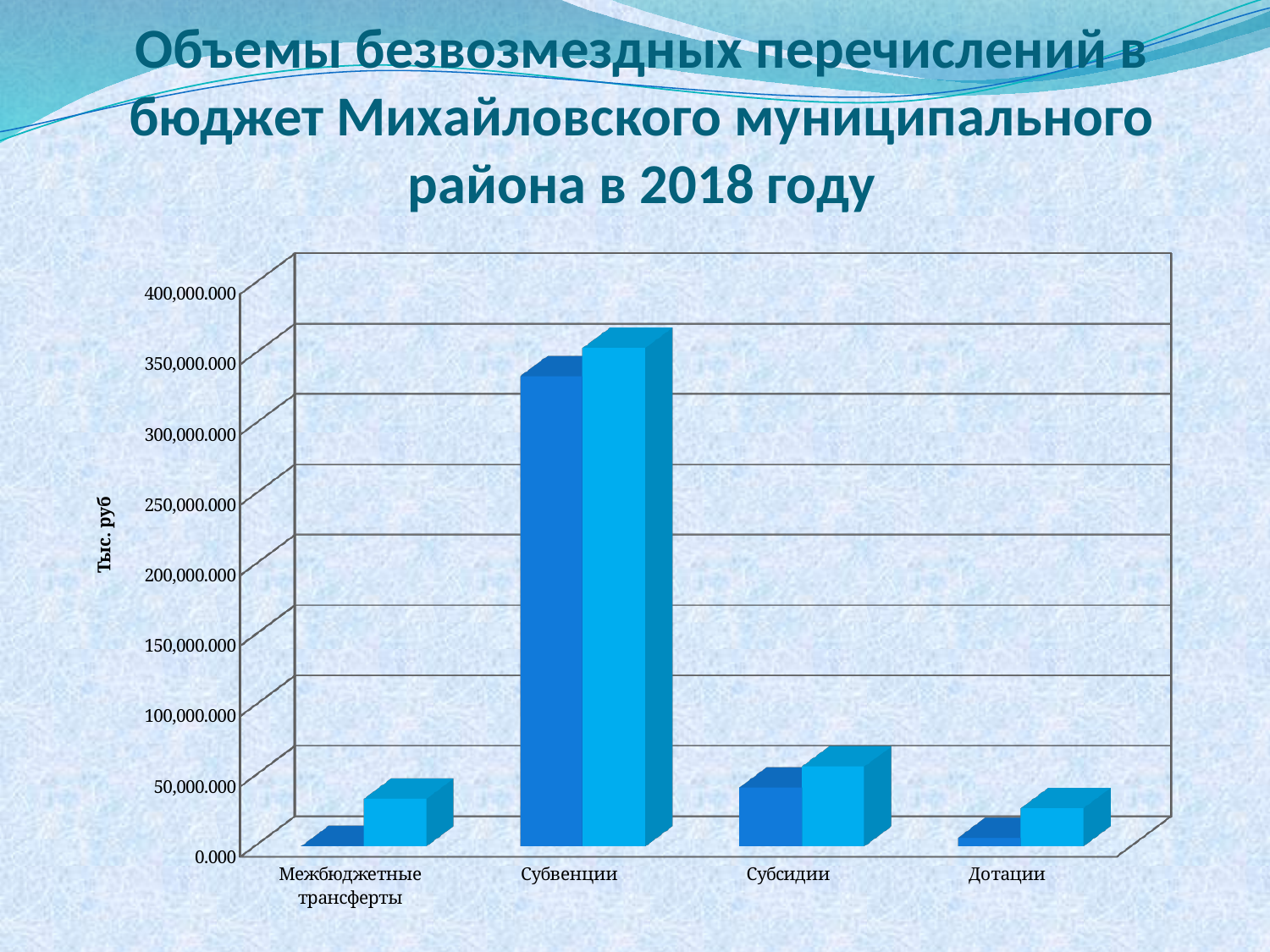
Which category has larger bars, Субвенции or Субсидии? Субвенции Which category has the highest bars in the chart? Субвенции Is the light blue bar for Субвенции greater or less than 300,000.000? greater How many categories are shown on the x axis of the chart? 4 Is the dark blue bar for Дотации greater or less than 50,000.000? less Is the light blue bar for Субвенции greater or less than 400,000.000? less Which category has the lowest dark blue bar in the chart? Межбюджетные трансферты What is the label on the vertical axis of the chart? Тыс. руб What kind of chart is shown on the slide? bar chart How many bars are shown for each category in the chart? 2 Which category has a larger dark blue bar, Субсидии or Дотации? Субсидии